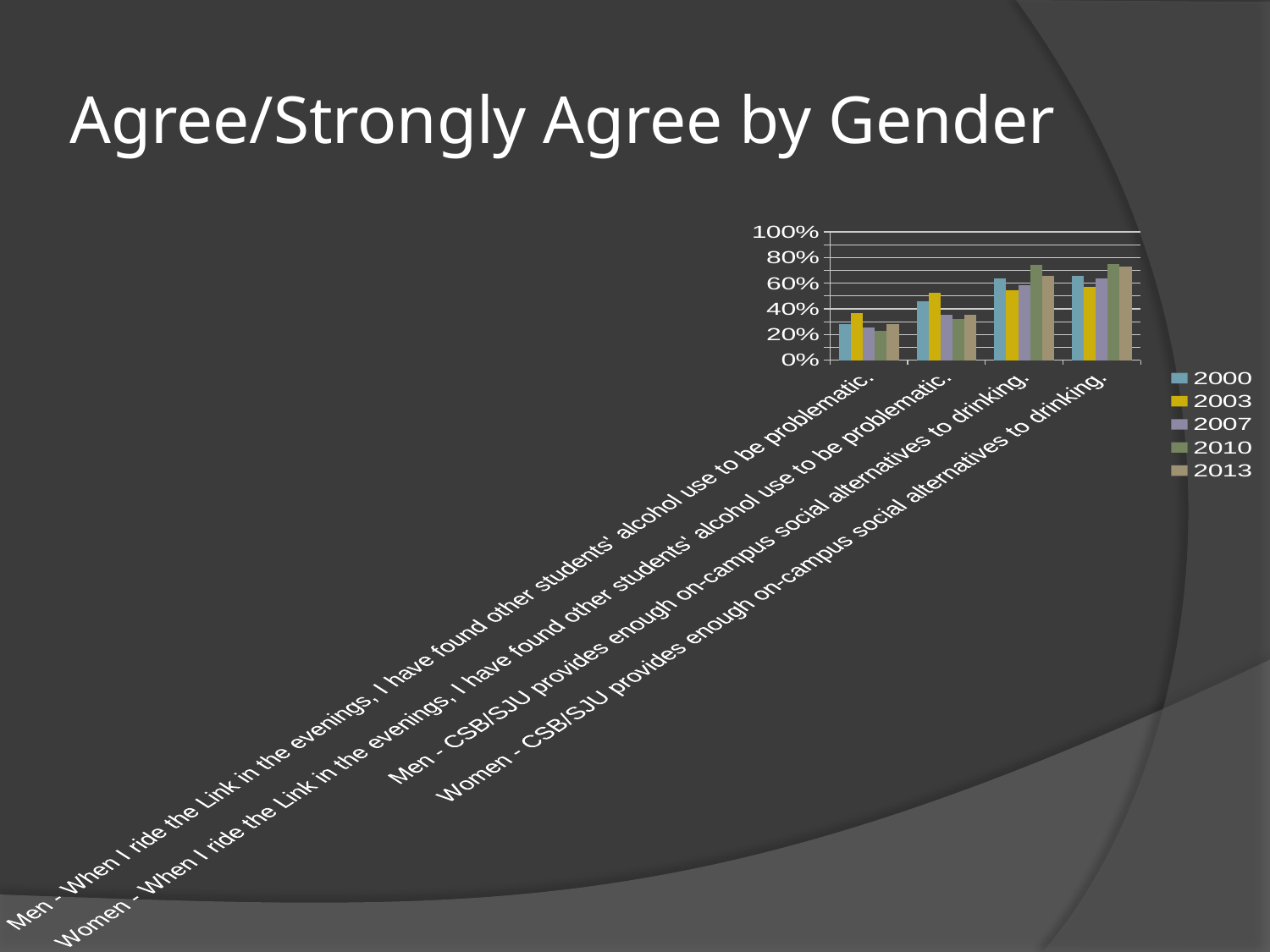
Is the 2003 value for "Men - When I ride the Link in the evenings, I have found other students' alcohol use to be problematic." greater or less than 20%? greater For "Women - When I ride the Link in the evenings, I have found other students' alcohol use to be problematic.", which year has the highest value? 2003 What kind of chart is shown on the slide? bar chart Which years are listed in the legend? 2000, 2003, 2007, 2010, 2013 What is the title of the slide containing the chart? Agree/Strongly Agree by Gender Is the 2003 value for "Women - CSB/SJU provides enough on-campus social alternatives to drinking." greater or less than 80%? less Is the 2010 value for "Men - CSB/SJU provides enough on-campus social alternatives to drinking." greater or less than 60%? greater For "Men - When I ride the Link in the evenings, I have found other students' alcohol use to be problematic.", which is larger, the 2003 value or the 2010 value? 2003 For "Men - CSB/SJU provides enough on-campus social alternatives to drinking.", which year has the highest value? 2010 How many categories are shown on the x axis? 4 How many series does the legend list? 5